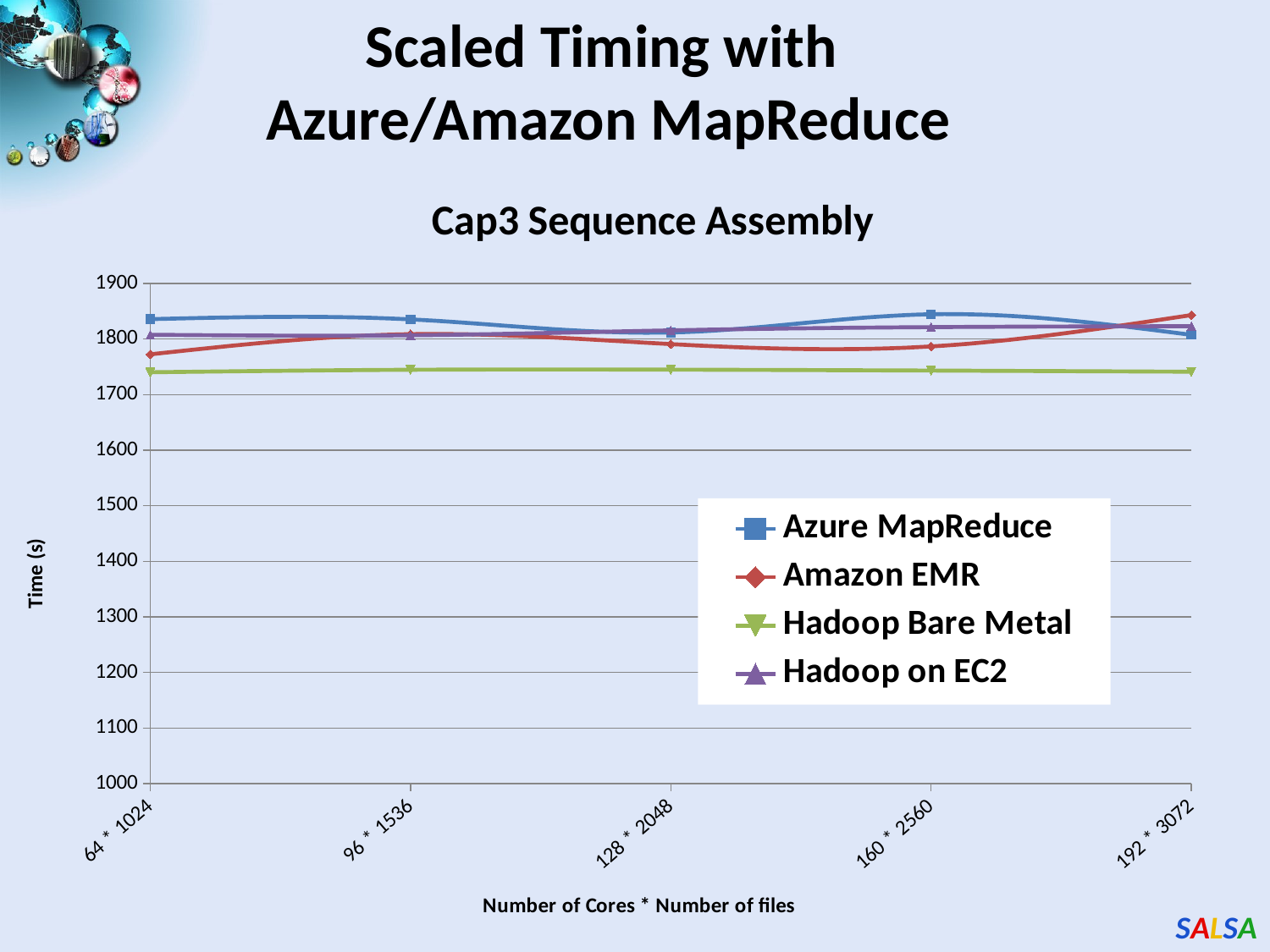
Is the value for Amazon EMR at 64 * 1024 greater or less than 1800? less Which series has the highest value at 192 * 3072? Amazon EMR Which series has the highest value at 64 * 1024? Azure MapReduce What is the label of the y axis? Time (s) Which series has the lowest value at 64 * 1024? Hadoop Bare Metal What is the title of the chart? Cap3 Sequence Assembly Is the value for Hadoop Bare Metal at 64 * 1024 greater or less than 1800? less What kind of chart is shown on the slide? line chart Is the value for Azure MapReduce at 64 * 1024 greater or less than 1800? greater At 64 * 1024, which is larger: Azure MapReduce or Hadoop Bare Metal? Azure MapReduce How many series does the legend list? 4 How many points are plotted along the x axis for each series? 5